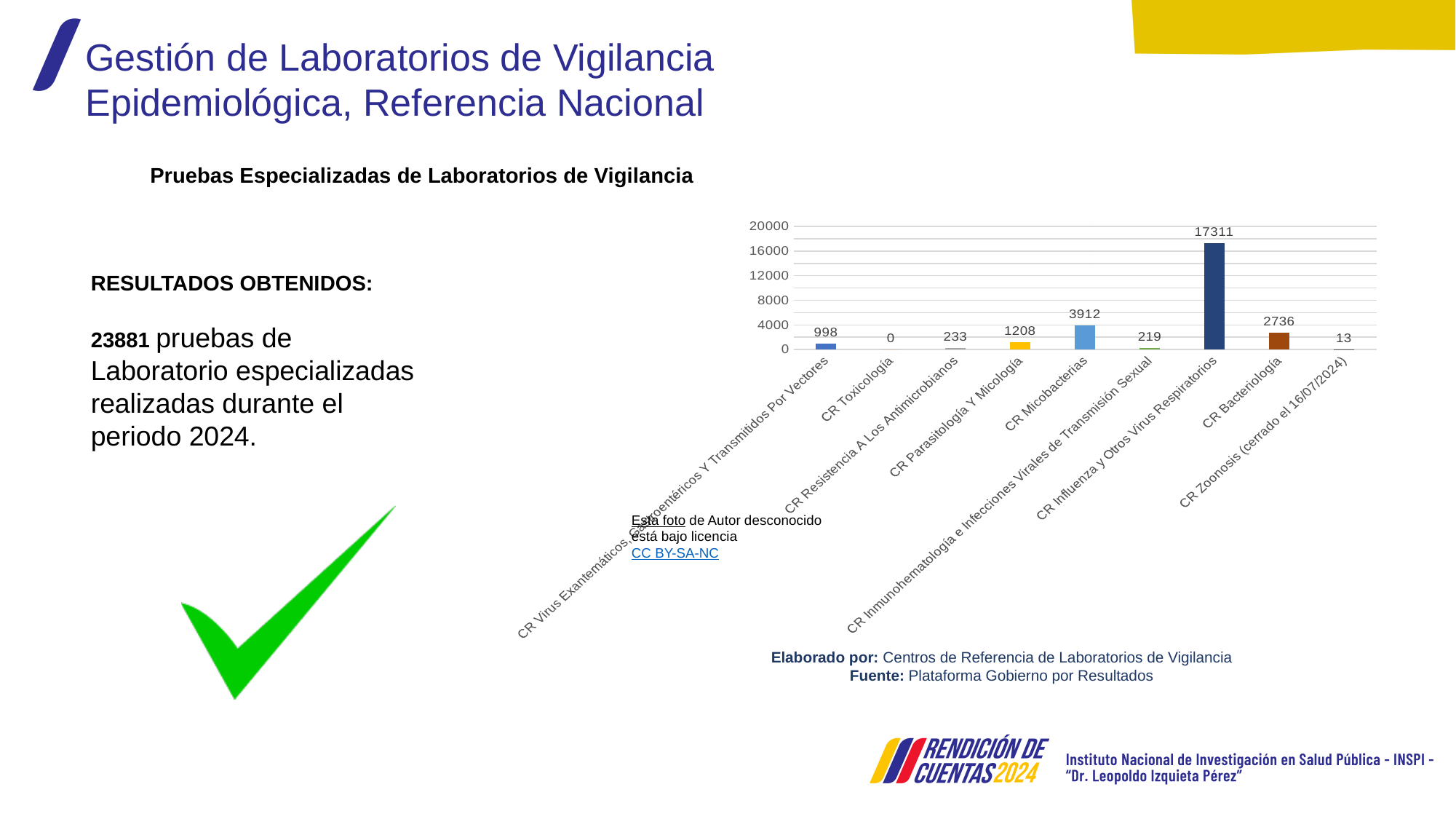
Which is larger, the value for CR Parasitología Y Micología or the value for CR Virus Exantemáticos, Gastroentéricos Y Transmitidos Por Vectores? CR Parasitología Y Micología What value is shown for CR Zoonosis (cerrado el 16/07/2024)? 13 What value is shown for CR Bacteriología? 2736 Which category has the lowest value? CR Toxicología What value is shown for CR Toxicología? 0 How many categories are shown on the x axis? 9 What is the difference between the values for CR Micobacterias and CR Bacteriología? 1176 Is the value for CR Influenza y Otros Virus Respiratorios greater or less than 16000? greater What kind of chart is shown on the slide? bar chart Which category has the highest value? CR Influenza y Otros Virus Respiratorios What is the value for CR Resistencia A Los Antimicrobianos? 233 What value is shown for CR Micobacterias? 3912